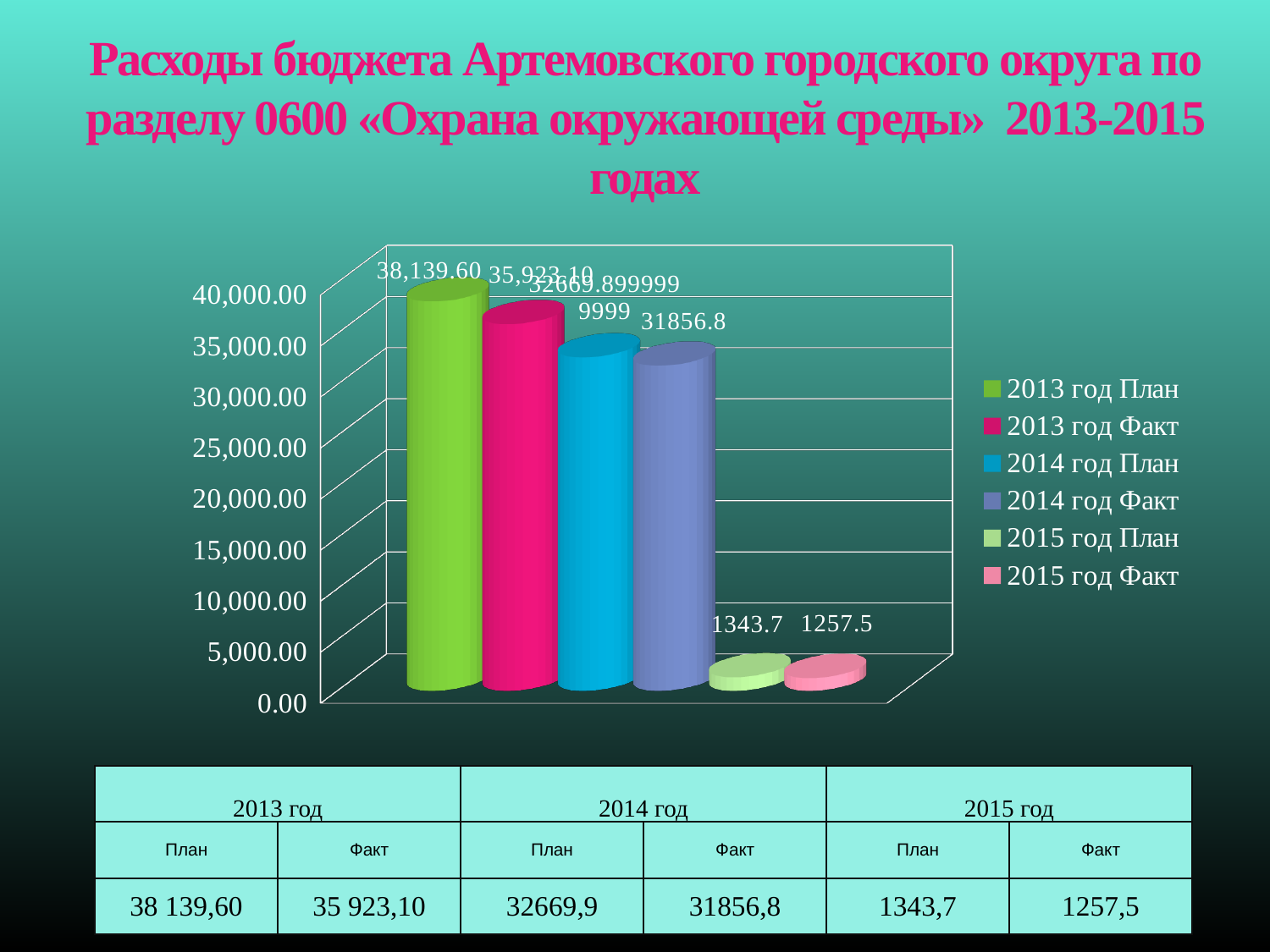
What is the value for 2015 год Факт? 1257.5 Is the value for 2014 год План greater or less than 30,000.00? greater How many series does the chart legend list? 6 What type of chart is shown on the slide? bar chart Which is larger, 2013 год Факт or 2014 год Факт? 2013 год Факт What is the value for 2013 год Факт? 35,923.10 Which series has the highest value? 2013 год План What is the value for 2013 год План? 38,139.60 Which series has the lowest value? 2015 год Факт What is the value for 2014 год Факт? 31856.8 What is the value for 2015 год План? 1343.7 What is the difference between 2015 год План and 2015 год Факт? 86.2